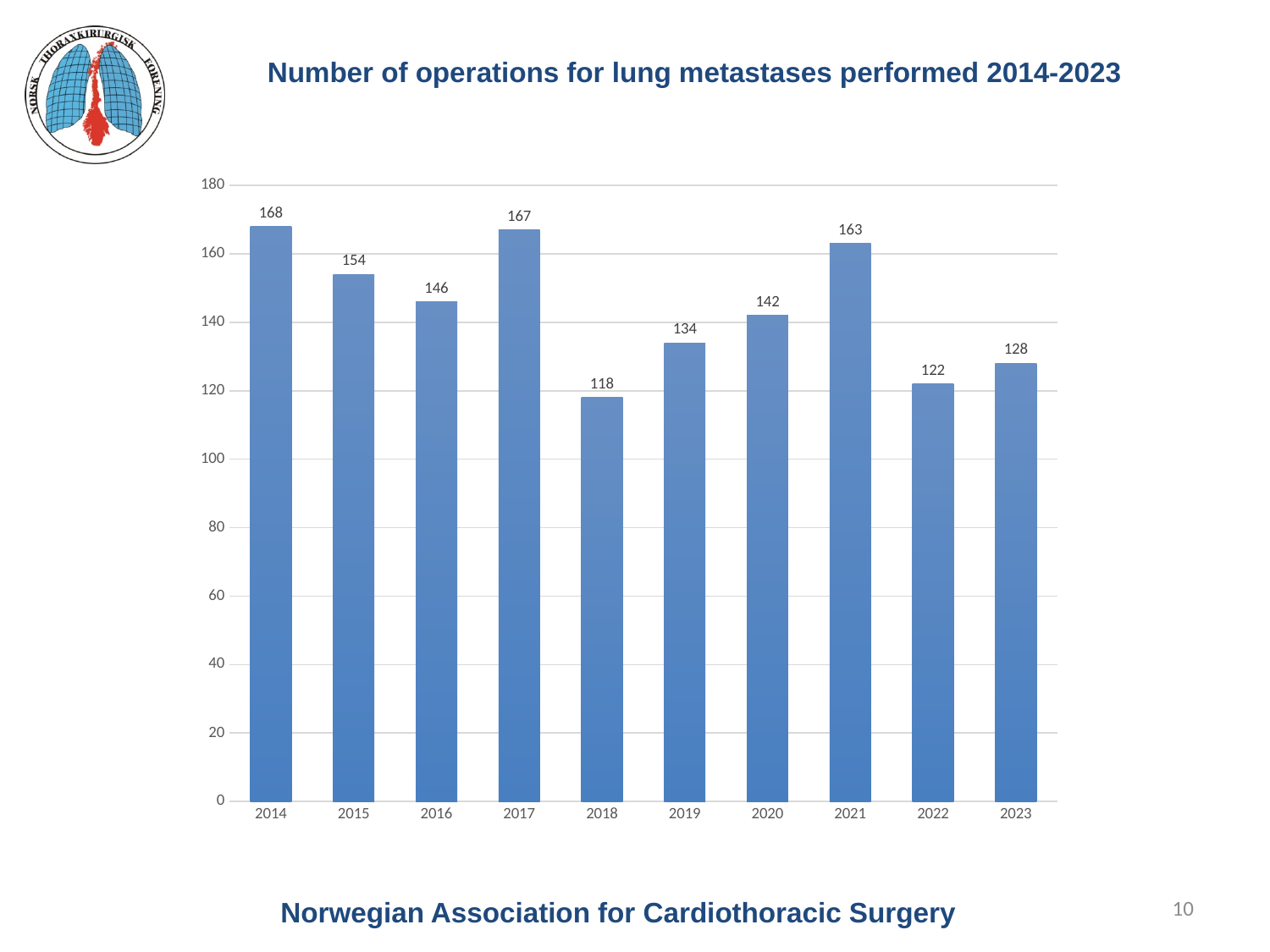
How many years are shown on the x axis? 10 What is the title of the chart? Number of operations for lung metastases performed 2014-2023 What is the difference between the values for 2021 and 2023? 35 Which year has the highest number of operations? 2014 Is the value for 2019 greater or less than 140? less What is the value shown for 2022? 122 Which year has a larger value, 2016 or 2020? 2016 Which year has the lowest number of operations? 2018 How many operations for lung metastases were performed in 2017? 167 Do the values rise or fall from 2021 to 2022? fall What kind of chart is shown on the slide? bar chart What is the difference between the values for 2014 and 2015? 14